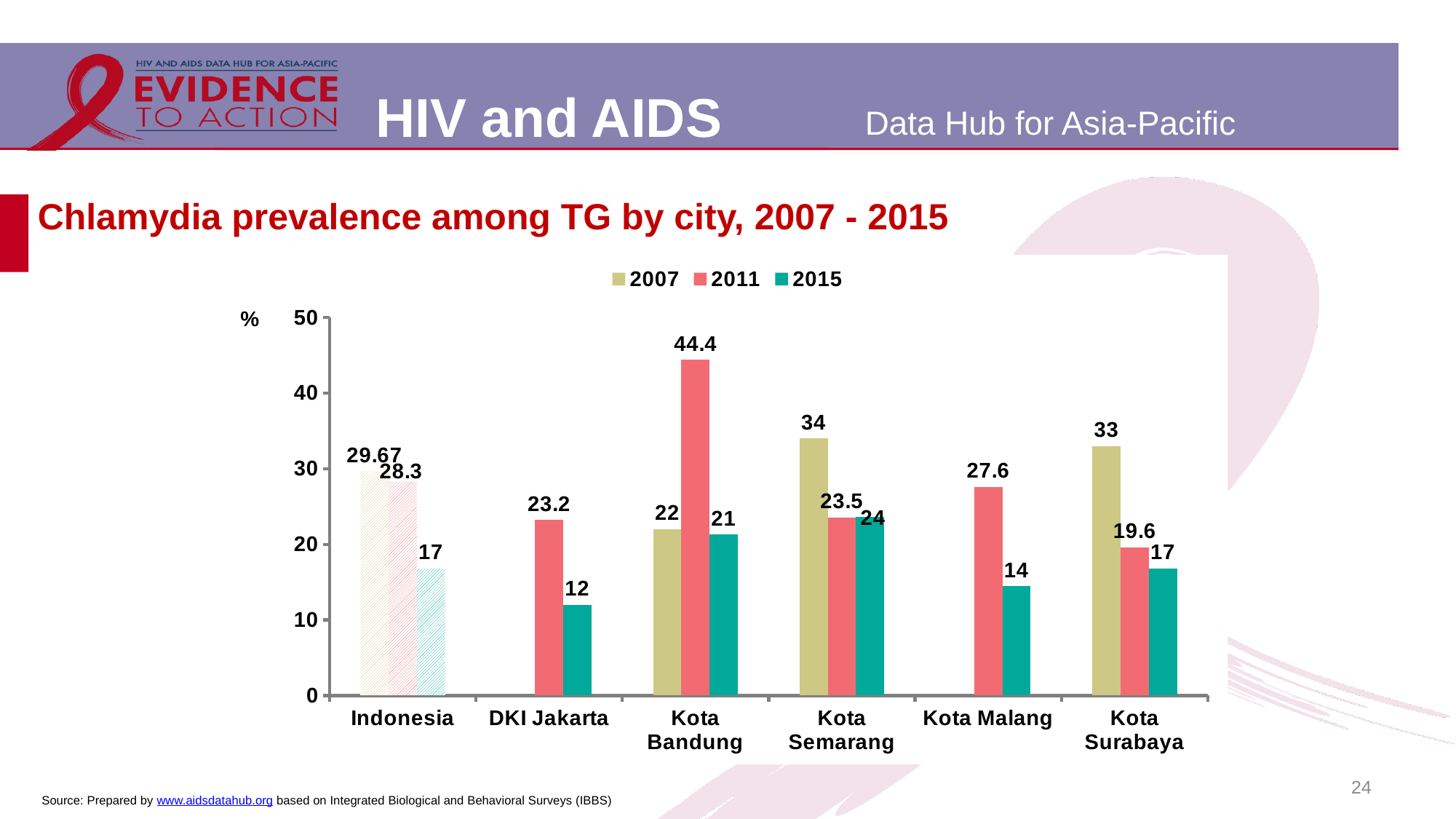
Which city had the highest chlamydia prevalence among TG in 2011? Kota Bandung Is the 2011 value for DKI Jakarta greater or less than 20? greater How many series does the legend list? 3 What was the chlamydia prevalence among TG in Kota Bandung in 2011? 44.4 Which city had the lowest chlamydia prevalence among TG in 2015? DKI Jakarta What was the chlamydia prevalence among TG in Kota Surabaya in 2015? 17 What is the difference between the 2011 and 2015 chlamydia prevalence values for Kota Malang? 13.6 What was the chlamydia prevalence among TG in Indonesia in 2007? 29.67 Which year does the legend associate with the red bars? 2011 What kind of chart is shown on the slide? Bar chart How many categories (locations) are shown on the x axis? 6 Which is larger: the 2007 value for Kota Semarang or the 2007 value for Kota Surabaya? Kota Semarang